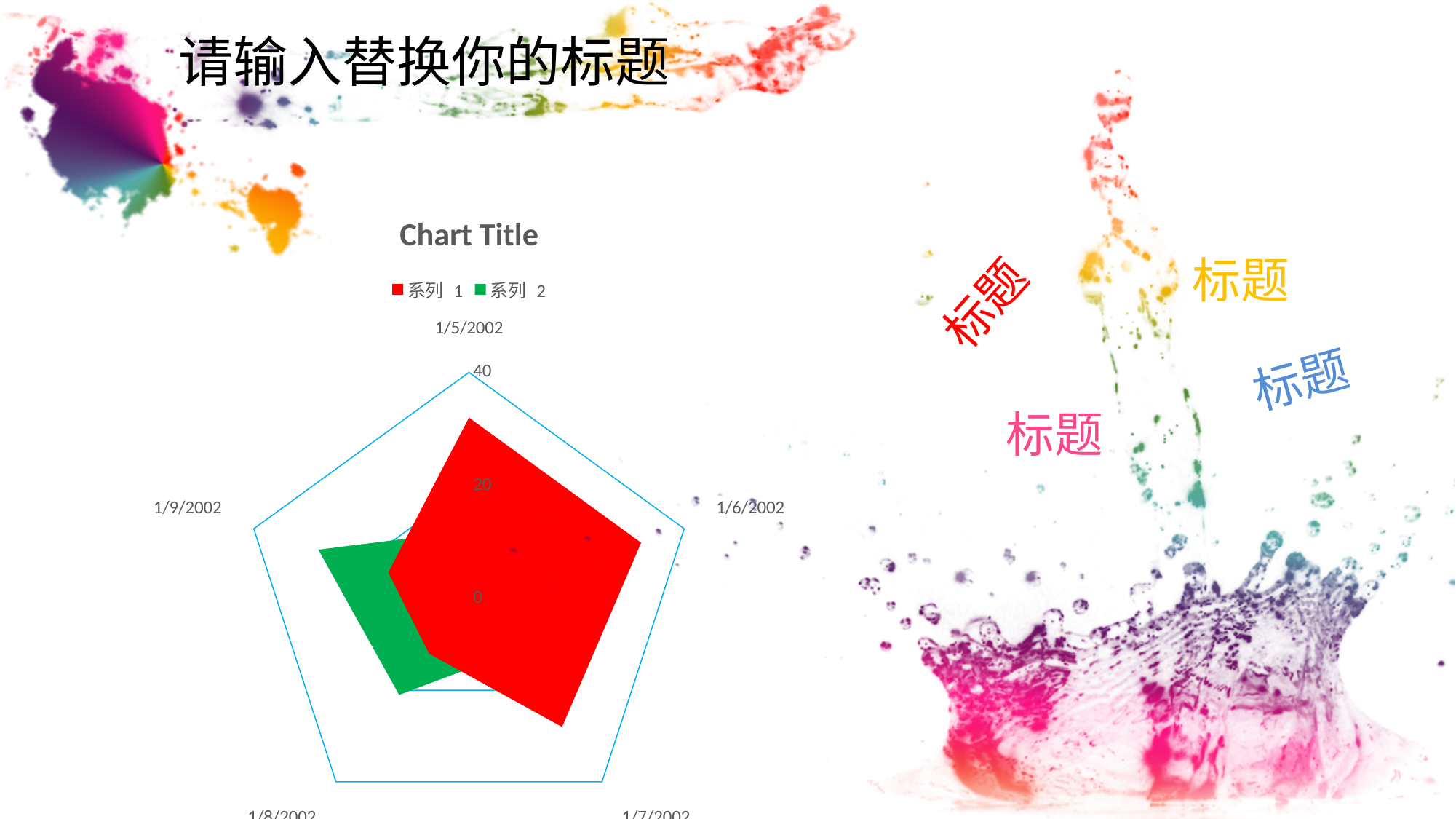
Is the value of 系列 1 for 1/9/2002 greater or less than 20? less What kind of chart is shown on the slide? radar chart Is the value of 系列 1 for 1/6/2002 greater or less than 20? greater Is the value of 系列 1 for 1/5/2002 greater or less than 40? less How many categories (dates) are plotted around the radar chart? 5 What is the title of the chart? Chart Title How many series does the legend list? 2 For 1/9/2002, which series has the larger value, 系列 1 or 系列 2? 系列 2 What are the two legend entries of the chart? 系列 1 and 系列 2